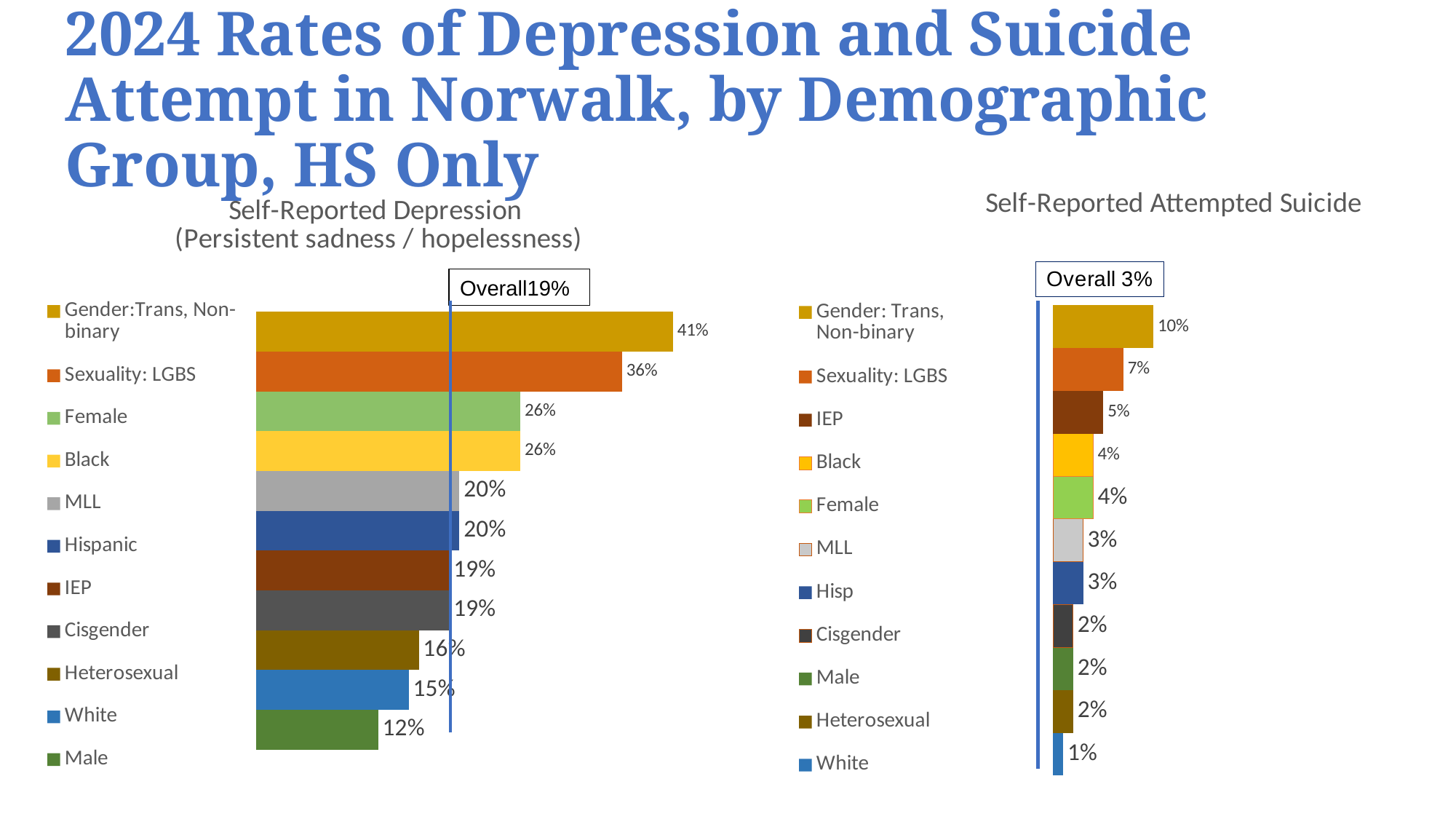
What overall rate is marked on the Self-Reported Attempted Suicide chart? Overall 3% What kind of chart is the Self-Reported Depression chart? Bar chart In the Self-Reported Depression chart, which group has the highest value? Gender:Trans, Non-binary In the Self-Reported Depression chart, what is the value for White? 15% In the Self-Reported Attempted Suicide chart, which is larger, the value for Sexuality: LGBS or the value for Black? Sexuality: LGBS How many demographic groups are plotted in the Self-Reported Attempted Suicide chart? 11 In the Self-Reported Depression chart, what is the value for Sexuality: LGBS? 36% In the Self-Reported Depression chart, which group has the lowest value? Male In the Self-Reported Attempted Suicide chart, which group has the highest value? Gender: Trans, Non-binary In the Self-Reported Attempted Suicide chart, what is the value for IEP? 5% In the Self-Reported Depression chart, what is the difference between the values for Gender:Trans, Non-binary and Male? 29% In the Self-Reported Attempted Suicide chart, what is the value for White? 1%